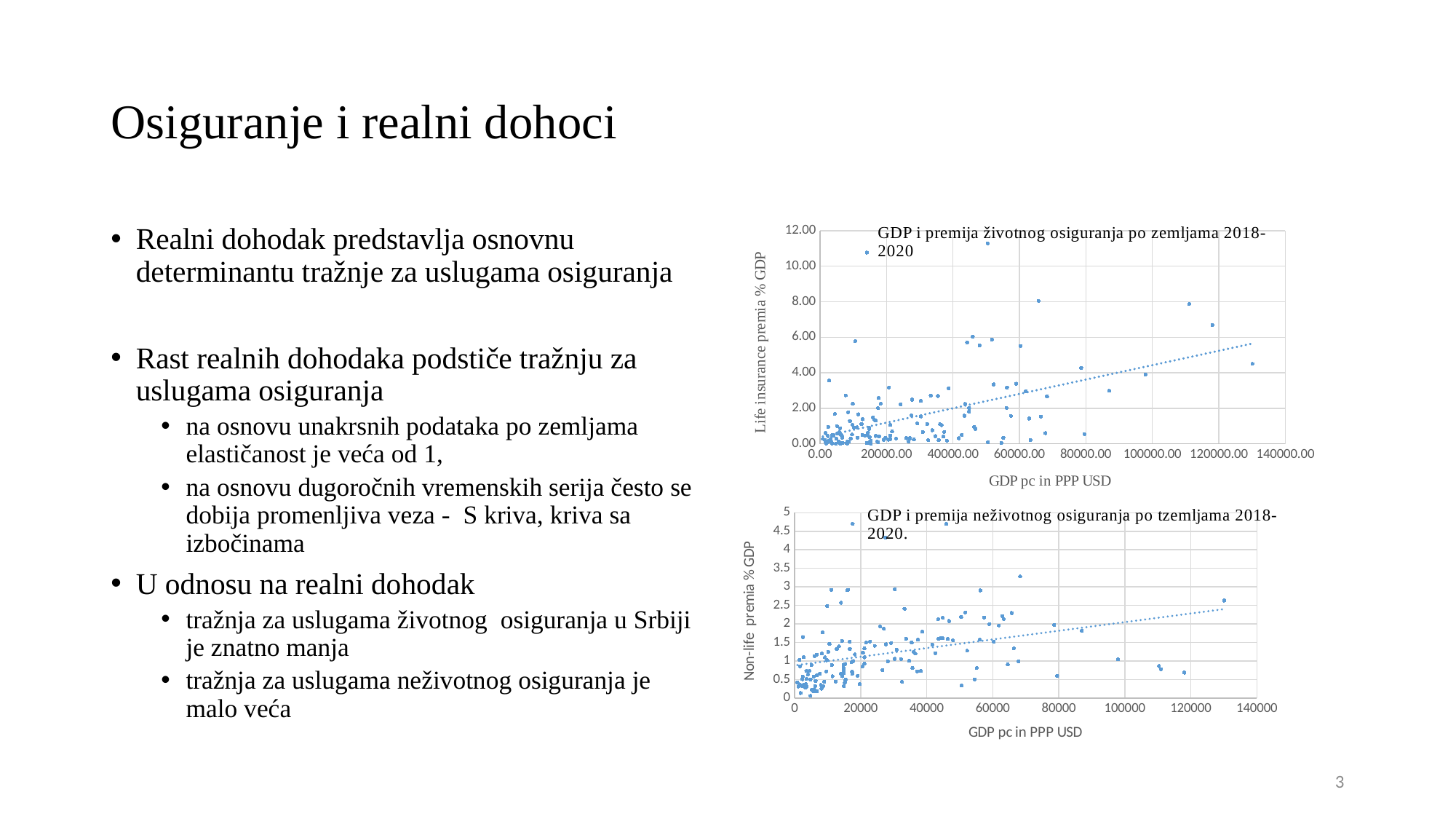
What is the vertical axis title of the top chart? Life insurance premia % GDP In the top chart (life insurance), is the highest plotted point greater or less than 10.00? greater What is the horizontal axis title of the bottom chart? GDP pc in PPP USD In the top chart (life insurance), does the dotted trend line rise or fall as GDP per capita increases? rise In the bottom chart (non-life insurance), is the highest plotted point greater or less than 4? greater In the bottom chart (non-life insurance), does the dotted trend line rise or fall as GDP per capita increases? rise What kind of chart is the bottom chart, 'GDP i premija neživotnog osiguranja po tzemljama 2018-2020'? scatter chart In the bottom chart (non-life insurance), is the value of the rightmost point (near 130000 GDP pc) greater or less than 2? greater What kind of chart is the top chart, 'GDP i premija životnog osiguranja po zemljama 2018-2020'? scatter chart